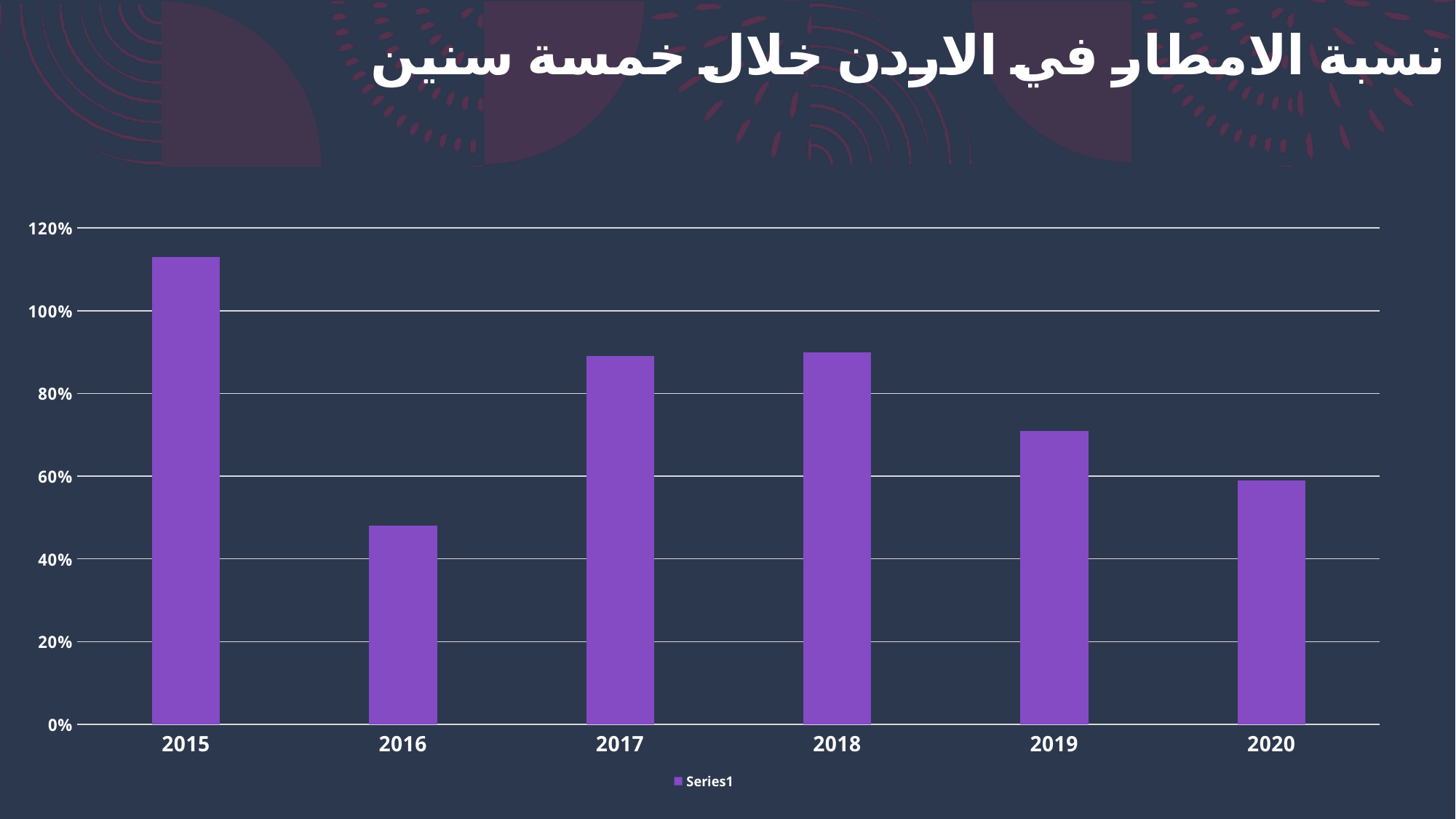
Which is larger, the value for 2019 or the value for 2020? 2019 Is the value for 2017 greater or less than 80%? greater Which is larger, the value for 2016 or the value for 2018? 2018 Which year has the highest bar? 2015 Is the value for 2019 greater or less than 80%? less Is the value for 2015 greater or less than 100%? greater Which year has the lowest bar? 2016 How many series does the legend list? 1 What kind of chart is shown on the slide? bar chart How many years are shown on the x axis of the chart? 6 What is the name of the series shown in the legend? Series1